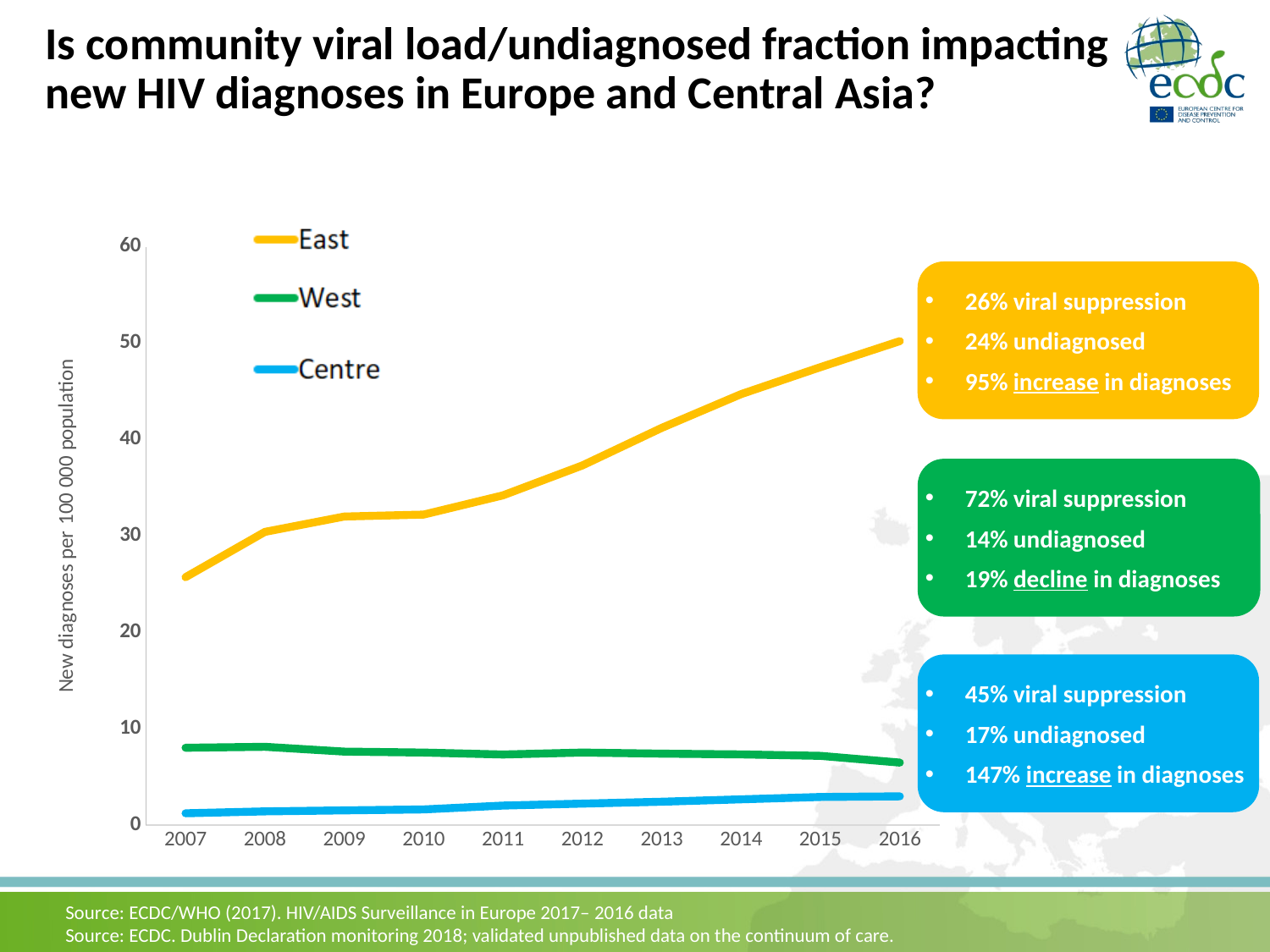
Which region has the lowest rate of new diagnoses in 2016? Centre Does the East line rise or fall from 2007 to 2016? rise Is the value for East in 2007 greater or less than 30? less What is the label on the y axis of the chart? New diagnoses per 100 000 population Is the value for East in 2016 greater or less than 40? greater Is the value for West in 2007 greater or less than 10? less Which region has the highest rate of new diagnoses in 2016? East Which is larger in 2010, the value for West or the value for Centre? West How many years are shown along the x axis of the chart? 10 How many series does the chart's legend list? 3 Does the West line rise or fall from 2007 to 2016? fall What kind of chart is shown on the slide? line chart